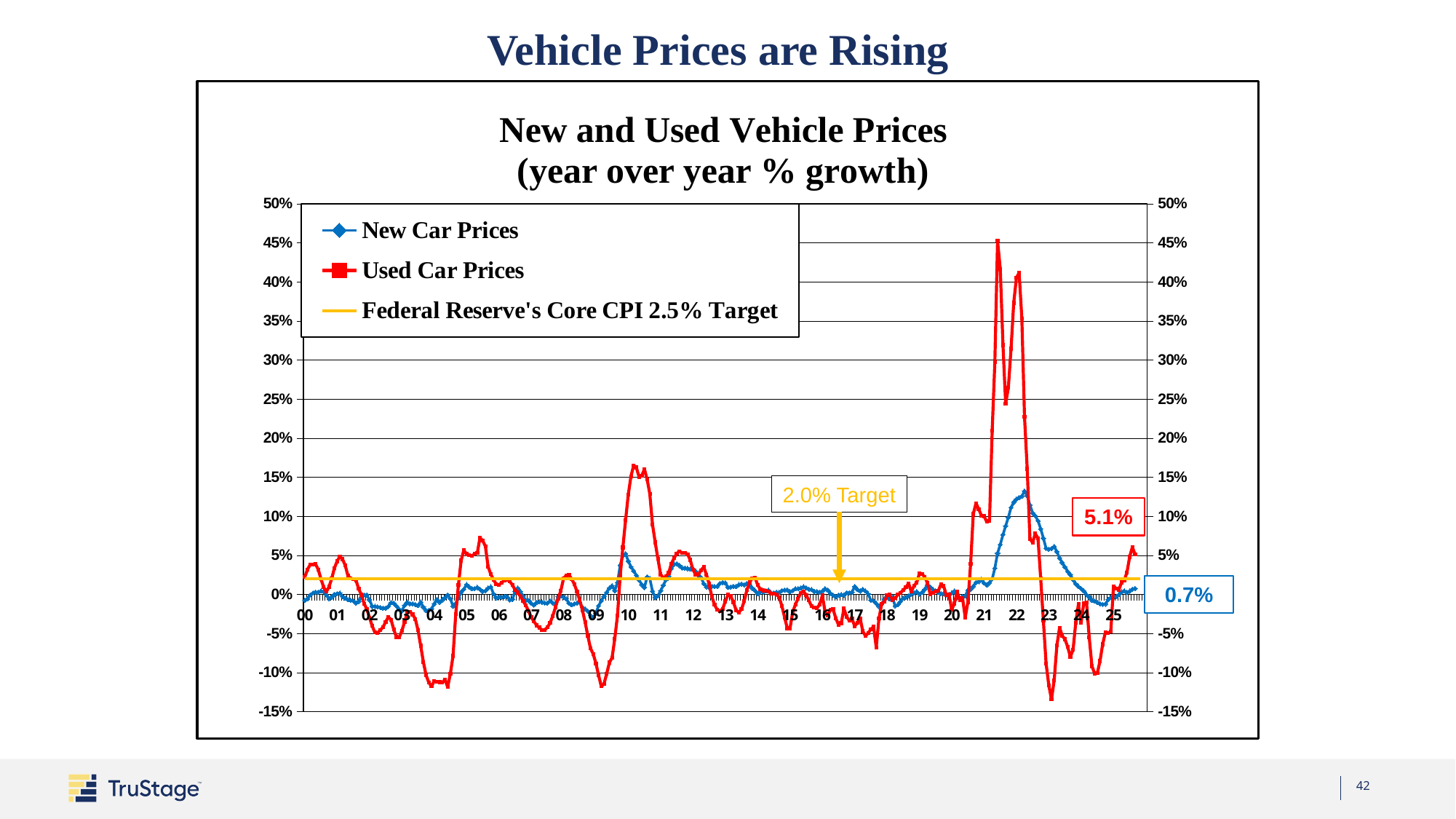
Which is larger at the end of the chart, the labelled value for Used Car Prices or for New Car Prices? Used Car Prices Is the peak value of New Car Prices around 2022 greater or less than 10%? greater Do Used Car Prices rise or fall between 2022 and 2023? fall Is the lowest value of Used Car Prices around 2023 greater or less than -10%? less What kind of chart is shown on the slide? line chart What is the difference between the labelled end values for Used Car Prices (5.1%) and New Car Prices (0.7%)? 4.4% What is the latest labelled value for Used Car Prices? 5.1% Is the peak value of Used Car Prices around 2021 greater or less than 40%? greater What is the title of the chart? New and Used Vehicle Prices (year over year % growth) How many series does the legend list? 3 What is the latest labelled value for New Car Prices? 0.7% Which series reaches the highest value anywhere on the chart? Used Car Prices